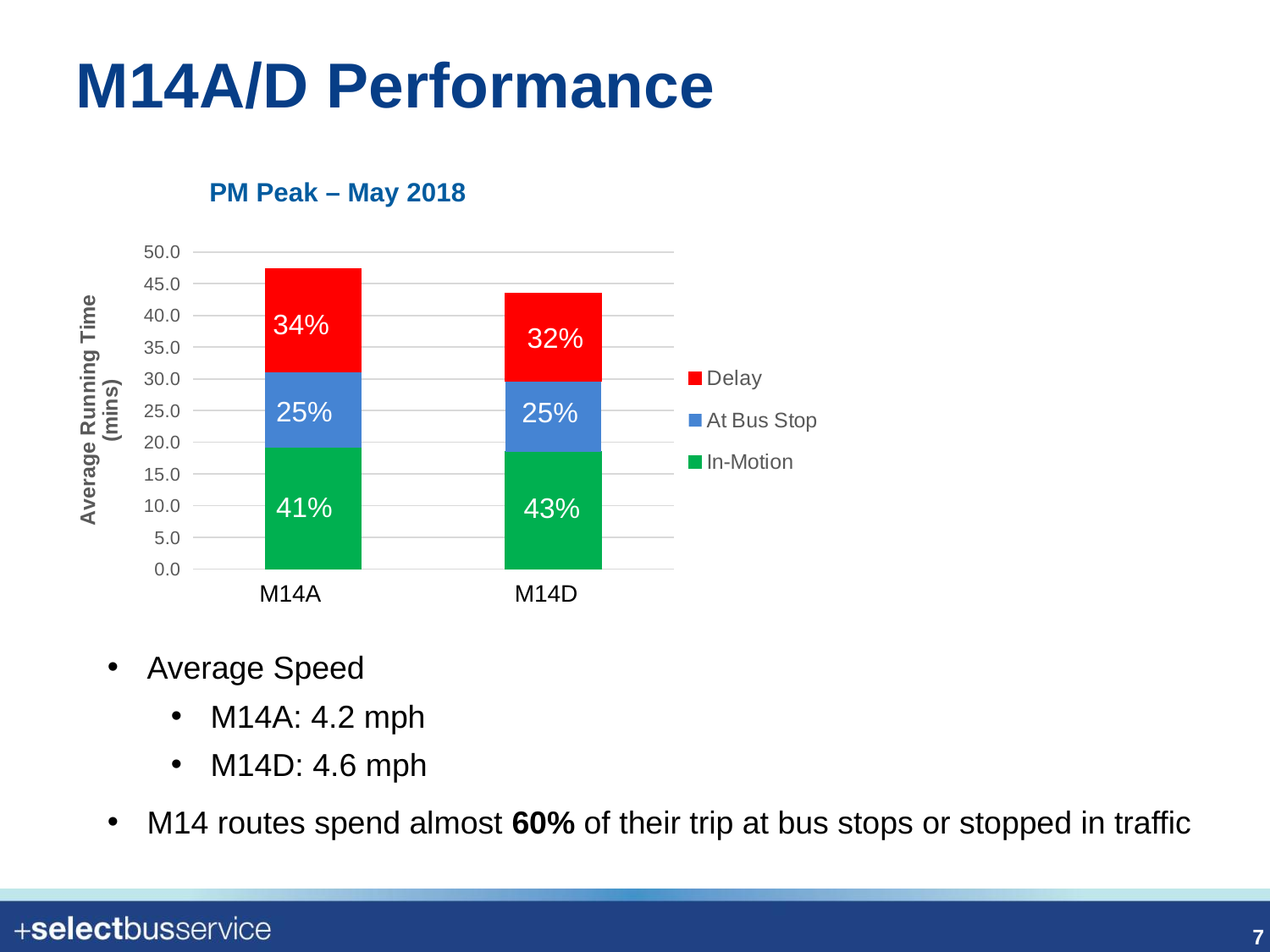
What is the title shown above the chart? PM Peak – May 2018 Is the total average running time for the M14A bar greater or less than 45.0 minutes? greater Is the total average running time for the M14D bar greater or less than 45.0 minutes? less What percentage label is shown for the Delay segment of the M14A bar? 34% What kind of chart is shown on the slide? Stacked bar chart What percentage label is shown for the In-Motion segment of the M14D bar? 43% What is the difference between the Delay percentage labels for M14A and M14D? 2% What percentage label is shown for the At Bus Stop segment of the M14A bar? 25% Which route has the larger In-Motion percentage label, M14A or M14D? M14D What percentage label is shown for the Delay segment of the M14D bar? 32% How many routes (categories) are plotted on the x axis? 2 How many series does the legend list? 3